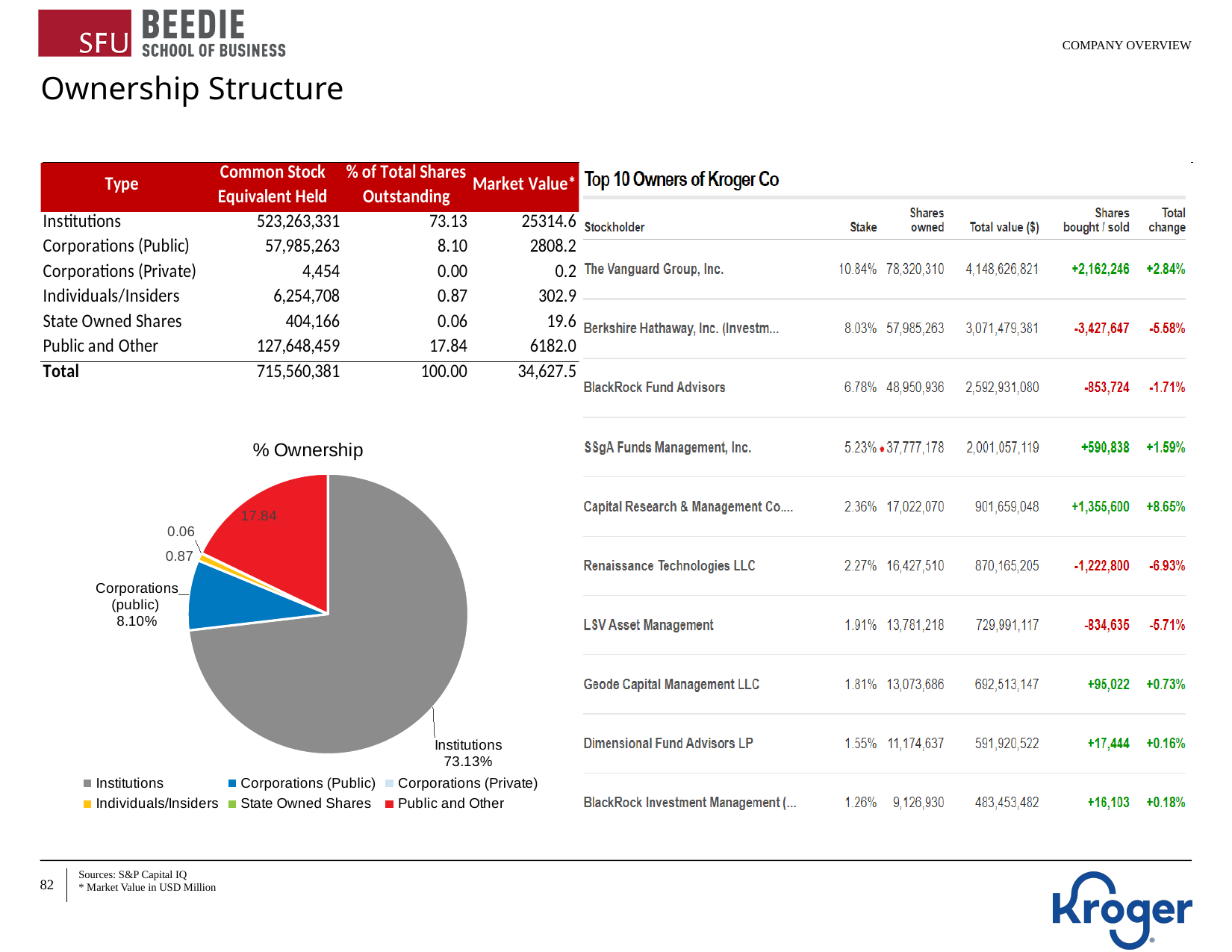
In the "% Ownership" pie chart, what is the value shown for Institutions? 73.13% What colour is the Institutions slice in the "% Ownership" pie chart? grey What is the title of the pie chart? % Ownership In the "% Ownership" pie chart, what value is labelled on the Individuals/Insiders slice? 0.87 In the "% Ownership" pie chart, what is the value shown for Corporations (public)? 8.10% How many entries does the legend of the "% Ownership" pie chart list? 6 In the "% Ownership" pie chart, which slice is larger: Public and Other or Corporations (public)? Public and Other In the "% Ownership" pie chart, what value is labelled on the red Public and Other slice? 17.84 In the "% Ownership" pie chart, what value is labelled on the State Owned Shares slice? 0.06 Which category has the largest slice in the "% Ownership" pie chart? Institutions In the "% Ownership" pie chart, what is the difference between the Institutions value (73.13%) and the Corporations (public) value (8.10%)? 65.03% What kind of chart is the "% Ownership" chart? pie chart